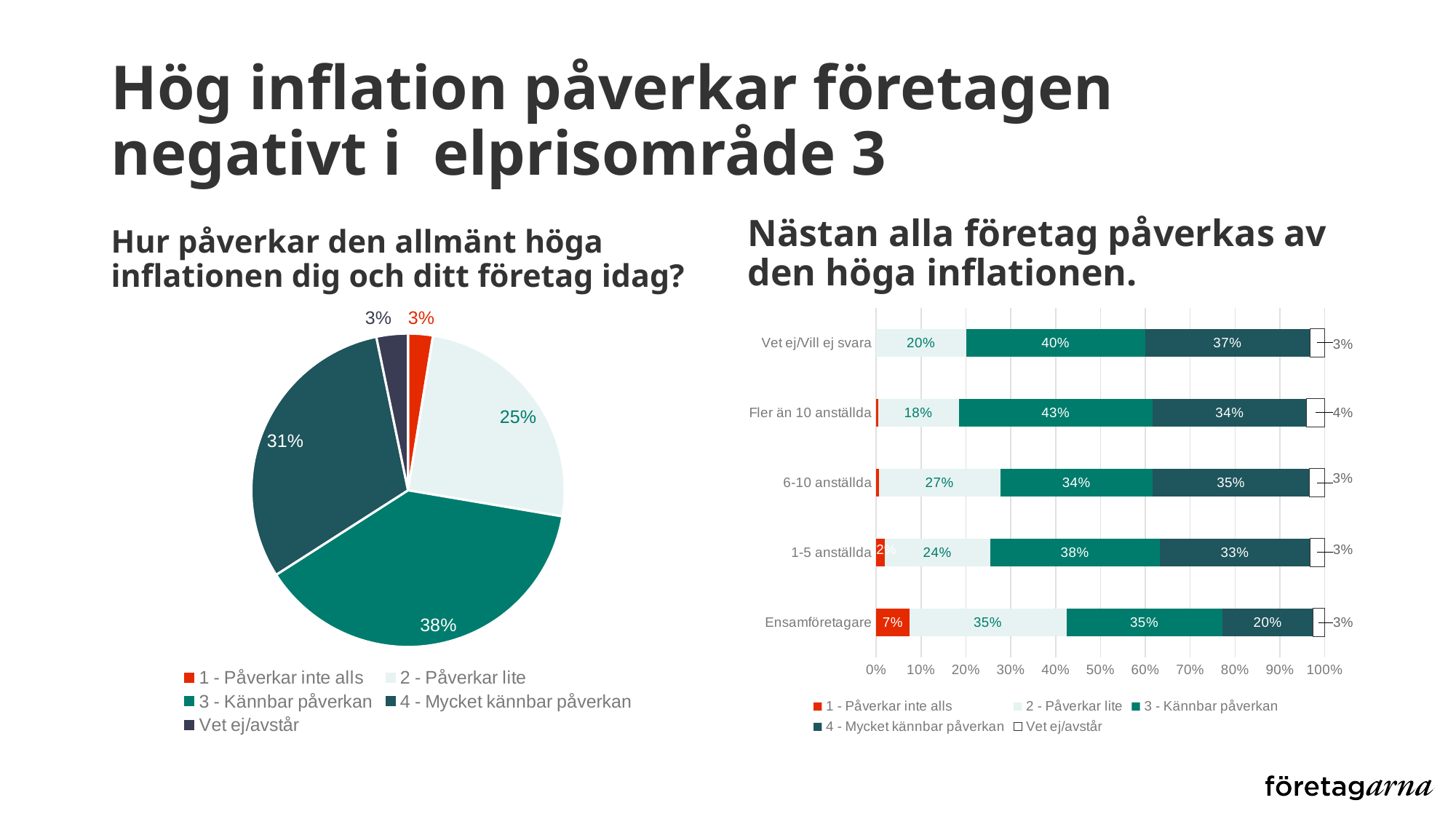
In the pie chart on the left, how many slices does the pie have? 5 How many series does the legend of the stacked bar chart on the right list? 5 In the stacked bar chart on the right, what is the value of '3 - Kännbar påverkan' for 'Fler än 10 anställda'? 43% What type of chart is shown on the right side of the slide? Stacked bar chart In the pie chart on the left, what share of respondents answered '2 - Påverkar lite'? 25% In the pie chart on the left, what is the difference in percentage points between '3 - Kännbar påverkan' and '4 - Mycket kännbar påverkan'? 7 percentage points In the stacked bar chart on the right, which category has the highest value for '4 - Mycket kännbar påverkan'? Vet ej/Vill ej svara In the stacked bar chart on the right, which is larger: '2 - Påverkar lite' for 'Ensamföretagare' or for '1-5 anställda'? Ensamföretagare In the pie chart on the left, what share of respondents answered '3 - Kännbar påverkan'? 38% In the pie chart on the left, which category has the largest slice? 3 - Kännbar påverkan In the stacked bar chart on the right, what is the value of '4 - Mycket kännbar påverkan' for 'Vet ej/Vill ej svara'? 37% In the stacked bar chart on the right, what is the value of '1 - Påverkar inte alls' for 'Ensamföretagare'? 7%